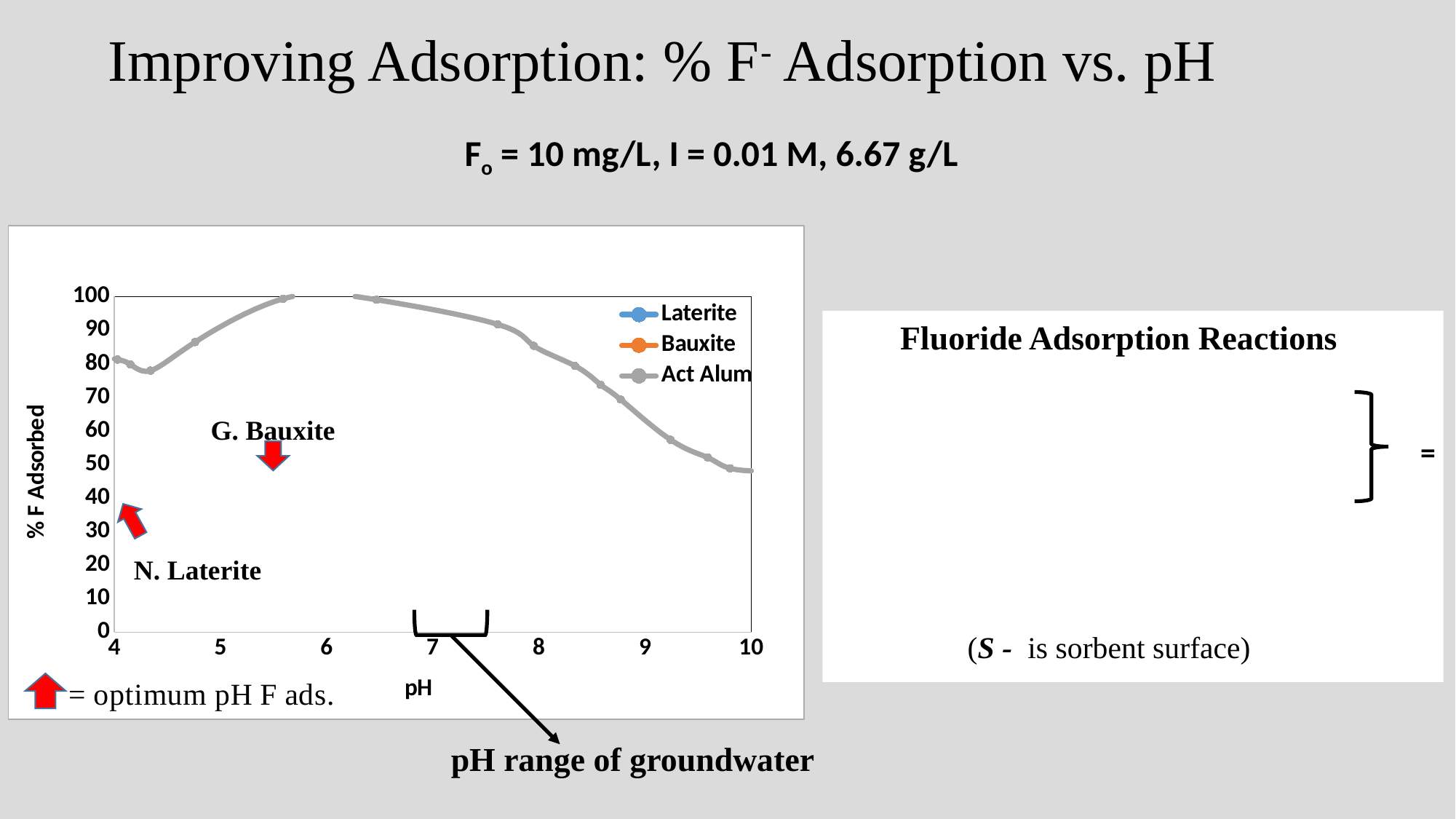
Is the value for Act Alum at pH 9 greater or less than 50? greater Is the value for Act Alum at pH 10 greater or less than 60? less How many series does the chart legend list? 3 What kind of chart is shown on the slide? line chart Is the value for Act Alum at pH 8 greater or less than 80? greater Is the value for Act Alum at pH 8 larger or smaller than its value at pH 9? larger Does the Act Alum line rise or fall as pH increases from 7 to 10? fall Which series in the legend is drawn in grey? Act Alum What is the label of the y axis of the chart? % F Adsorbed Does the Act Alum line rise or fall as pH increases from 4.5 to 5.5? rise